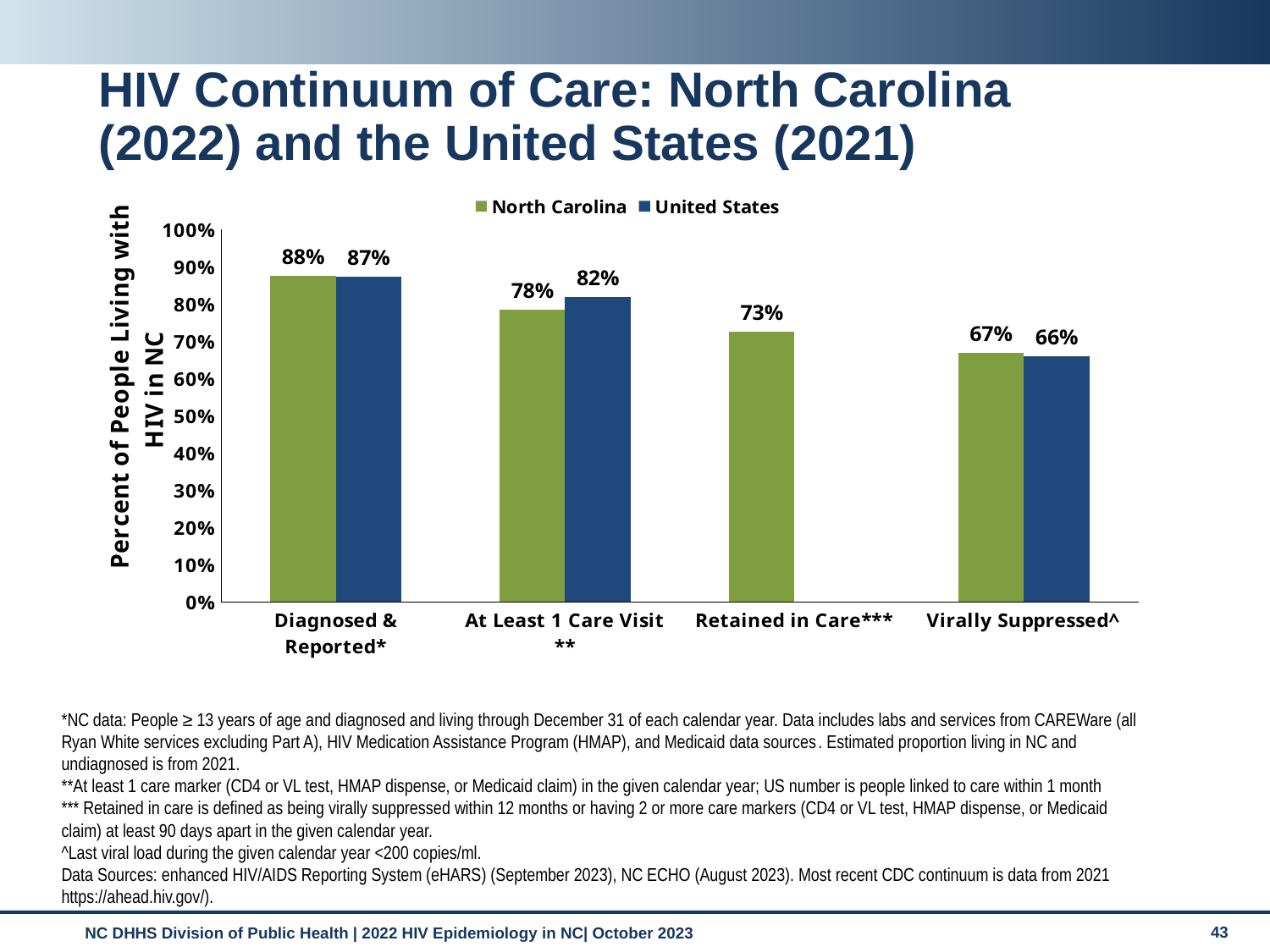
What is the North Carolina value for Retained in Care***? 73% For Virally Suppressed^, which is larger: the North Carolina value or the United States value? North Carolina What is the North Carolina value for Diagnosed & Reported*? 88% What kind of chart is shown on the slide? Bar chart How many series does the legend list? 2 What is the North Carolina value for Virally Suppressed^? 67% How many categories are shown on the x axis? 4 What is the United States value for At Least 1 Care Visit**? 82% Which category has the highest United States value? Diagnosed & Reported* Which category has the lowest North Carolina value? Virally Suppressed^ What is the difference between the United States and North Carolina values for At Least 1 Care Visit**? 4% Which category has no United States bar? Retained in Care***